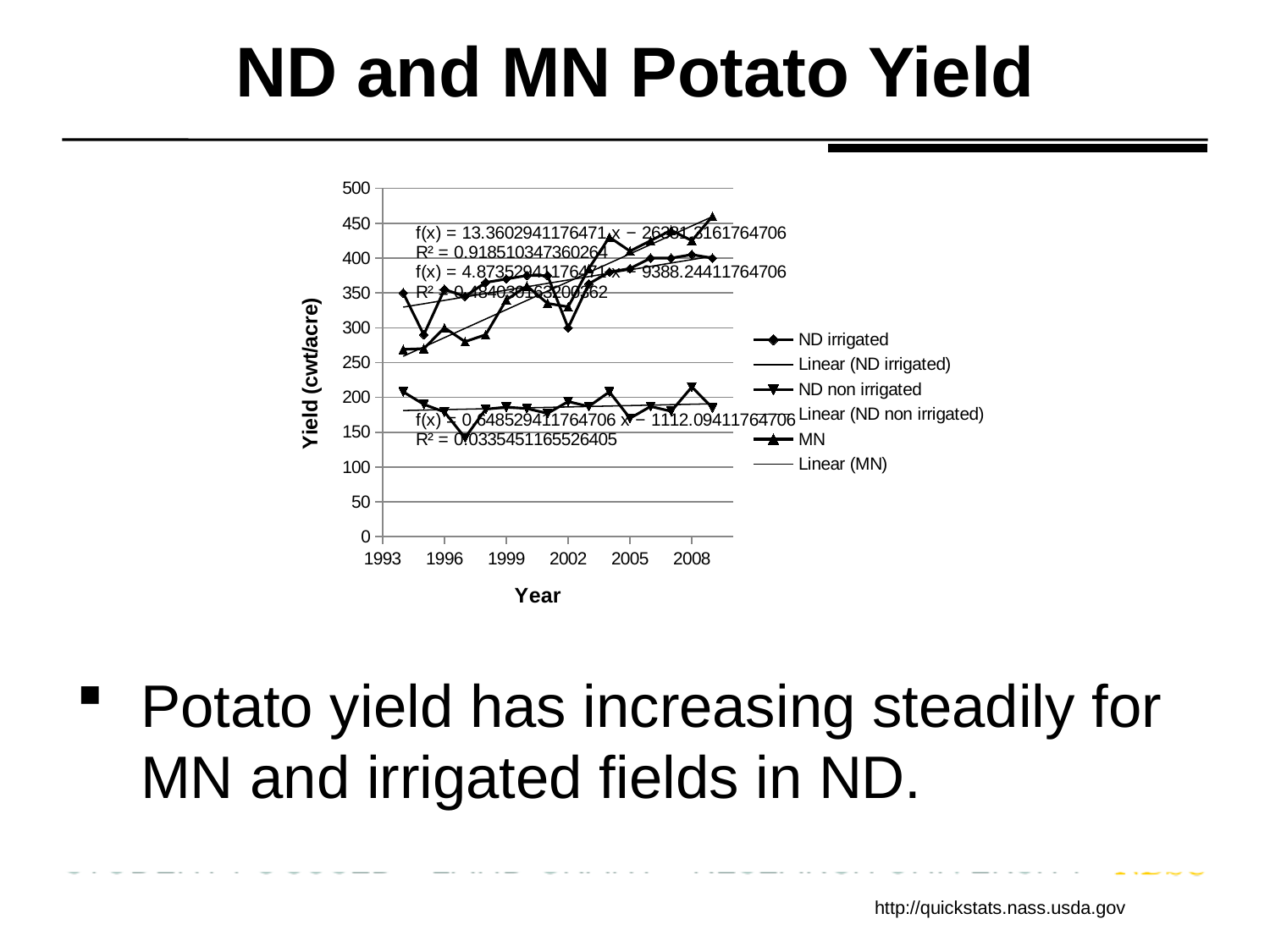
What is the label on the horizontal axis of the chart? Year Does the ND irrigated series generally rise or fall across the years shown? rise Which series reaches the highest yield value on the chart? MN Is the value for MN in 2009 greater or less than 400? greater What is the label on the vertical axis of the chart? Yield (cwt/acre) Which series has the lowest yield values throughout the years shown? ND non irrigated Is the value for ND non irrigated in 2008 greater or less than 250? less Is the value for MN in 1994 greater or less than 300? less What kind of chart is shown on the slide? line chart In 2008, which is larger: the MN yield or the ND non irrigated yield? MN How many entries does the chart legend list? 6 Does the MN series generally rise or fall from 1994 to 2009? rise